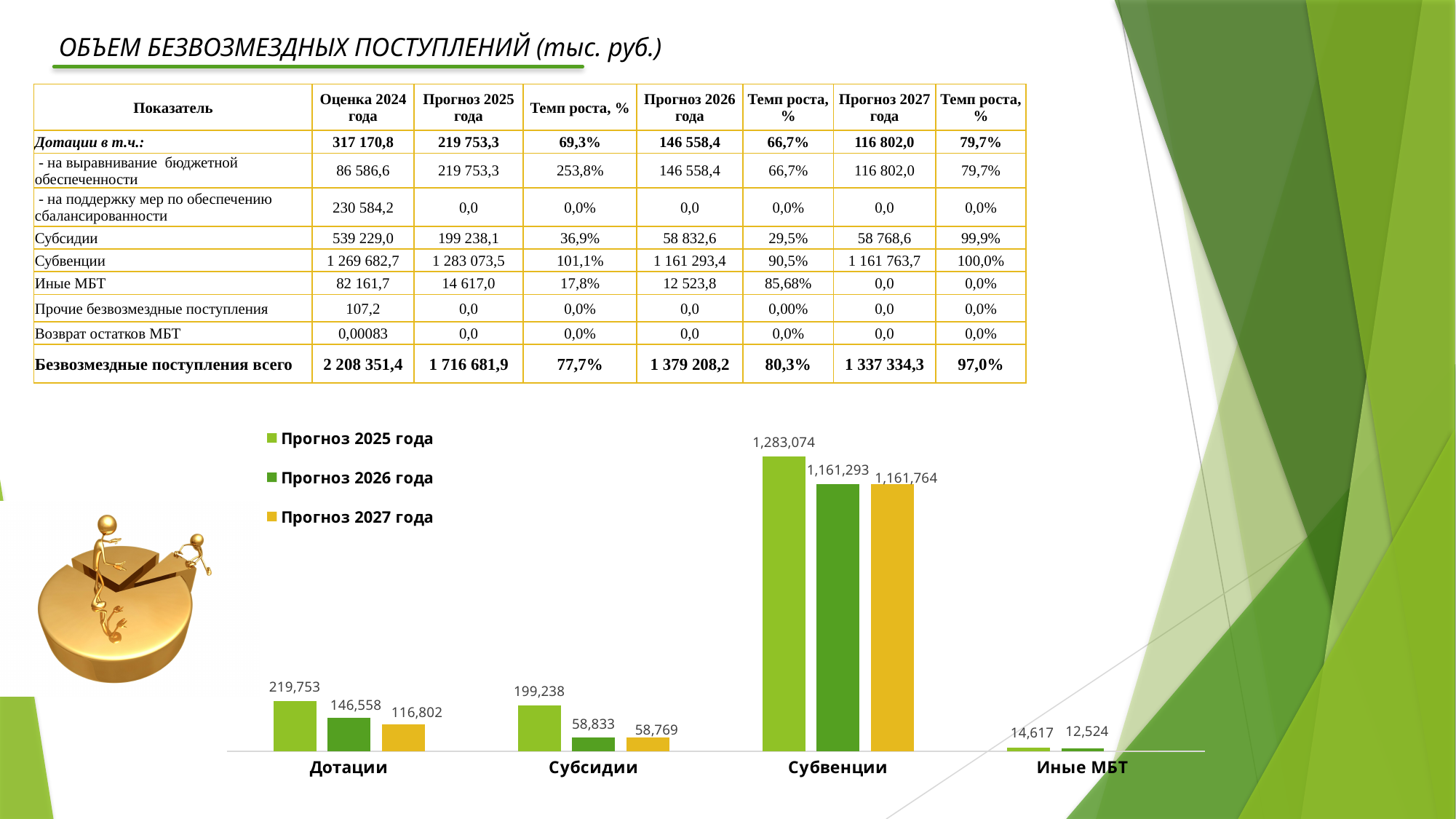
How many series does the chart legend list? 3 Which series in the chart legend is shown in yellow? Прогноз 2027 года In the chart, which is larger for Субсидии: the Прогноз 2025 года value or the Прогноз 2027 года value? Прогноз 2025 года Which category has the lowest value in the Прогноз 2026 года series of the chart? Иные МБТ In the chart, what is the difference between the Прогноз 2025 года and Прогноз 2026 года values for Дотации? 73,195 How many categories are shown on the x axis of the chart? 4 In the chart, what is the value for Иные МБТ in the Прогноз 2025 года series? 14,617 What type of chart is shown at the bottom of the slide? bar chart In the chart, what is the value for Субвенции in the Прогноз 2025 года series? 1,283,074 Which category has the highest value in the Прогноз 2025 года series of the chart? Субвенции In the chart, what is the value for Дотации in the Прогноз 2027 года series? 116,802 In the chart, what is the value for Субсидии in the Прогноз 2026 года series? 58,833